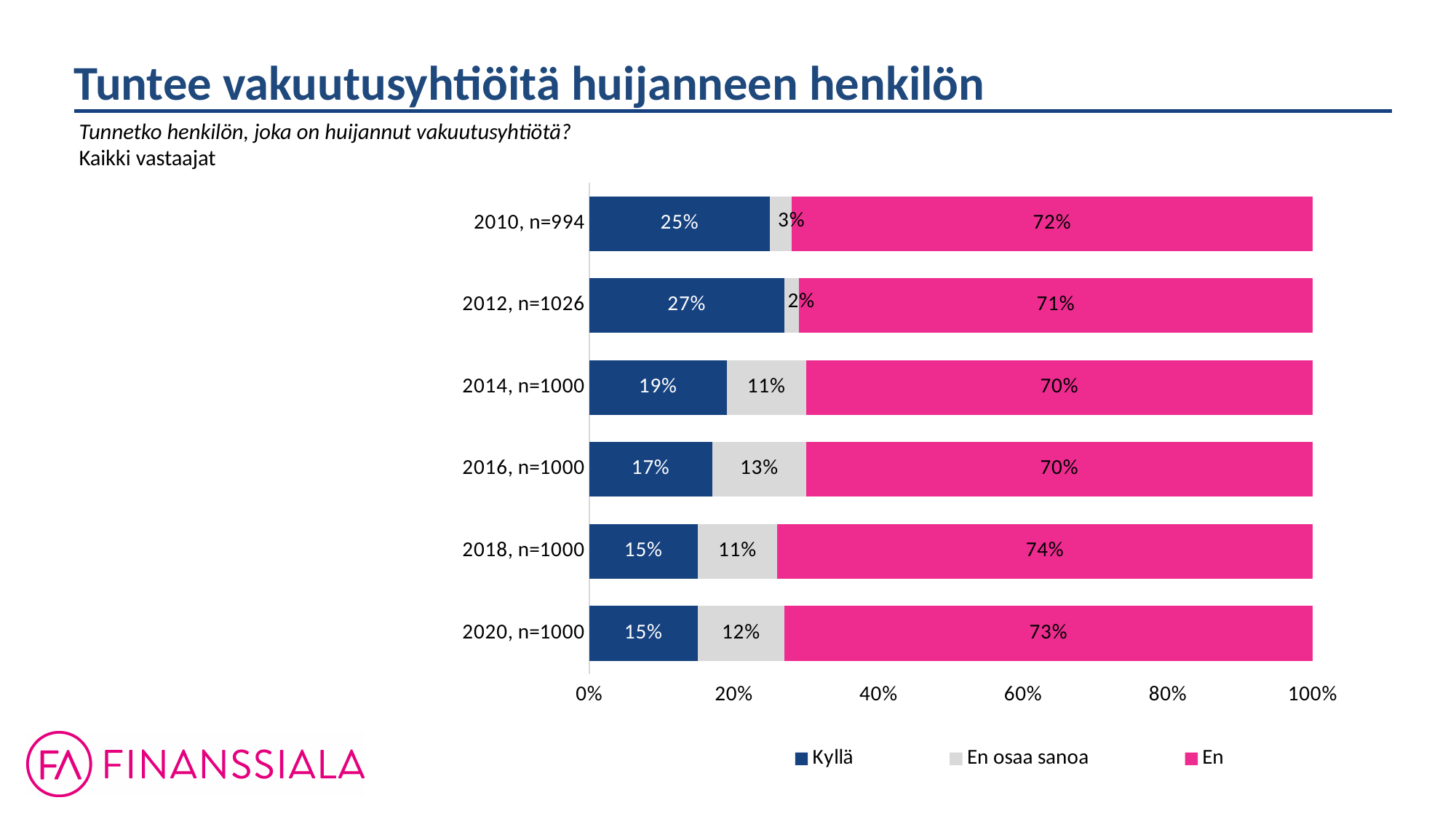
What percentage of respondents answered "En" in 2018, n=1000? 74% In which year is the "Kyllä" share highest? 2012, n=1026 Which colour represents the "En" series in the chart? Pink Does the "Kyllä" share generally rise or fall from 2012 to 2020? Fall What kind of chart is shown on the slide? Stacked bar chart Which is larger: the "En" value for 2010, n=994 or for 2014, n=1000? 2010, n=994 In which year is the "En osaa sanoa" share lowest? 2012, n=1026 How many series does the legend list? 3 What percentage of respondents answered "Kyllä" in 2010, n=994? 25% What is the difference between the "Kyllä" values for 2012, n=1026 and 2020, n=1000? 12 percentage points How many survey years are shown on the chart? 6 What is the "En osaa sanoa" value for 2016, n=1000? 13%